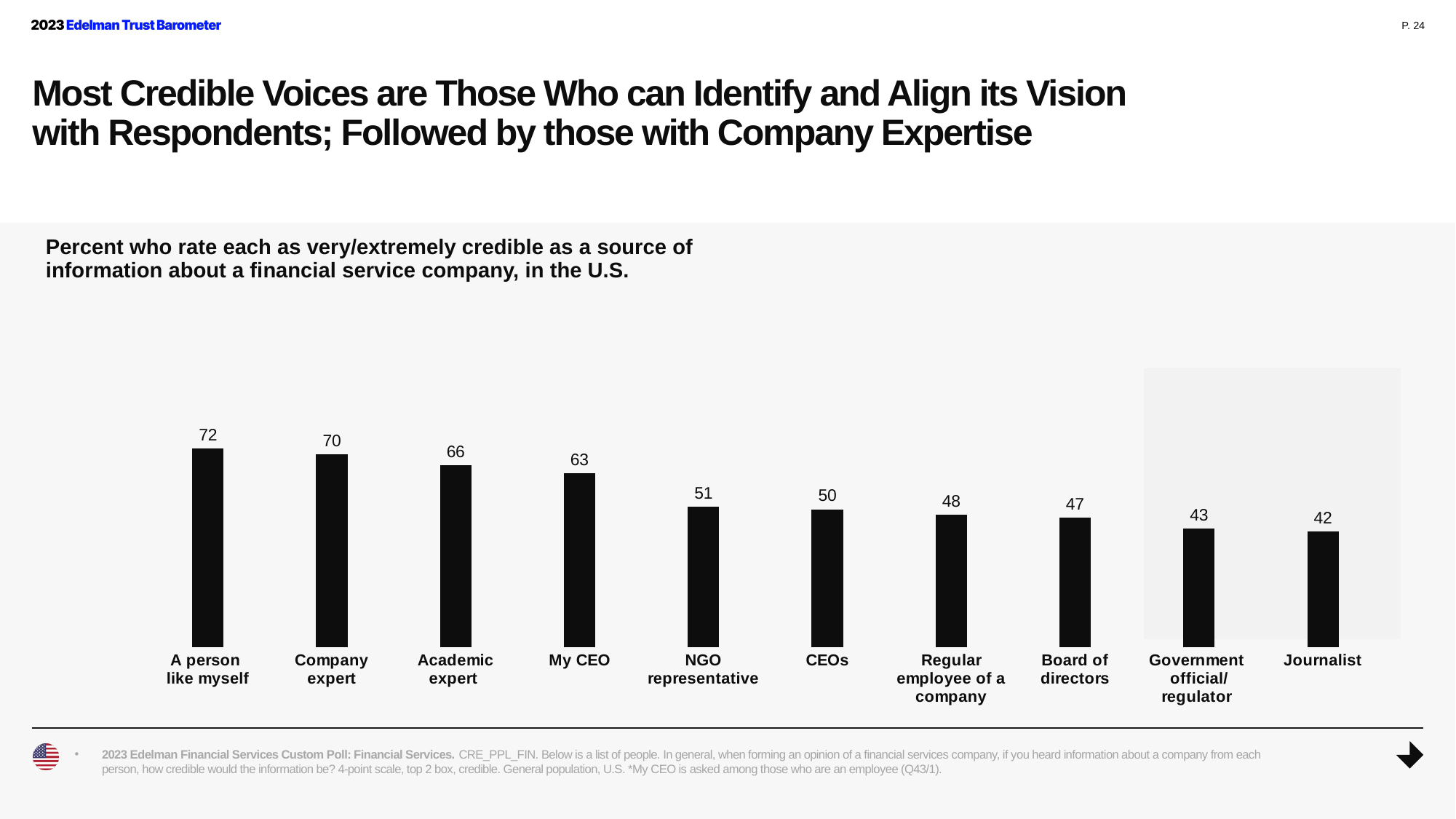
What is the value shown for 'Journalist'? 42 What is the difference between the values for 'Company expert' and 'Government official/regulator'? 27 What is the value shown for 'NGO representative'? 51 What kind of chart is shown on the slide? Bar chart Which category has the lowest value on the chart? Journalist What percent rate 'A person like myself' as very/extremely credible? 72 Which category has the highest value on the chart? A person like myself How many categories are shown on the chart? 10 What is the difference between the values for 'Academic expert' and 'Board of directors'? 19 Which has a higher value, 'My CEO' or 'CEOs'? My CEO Which two categories are highlighted with a shaded background on the chart? Government official/regulator and Journalist Do the values rise or fall moving from left to right across the chart? Fall